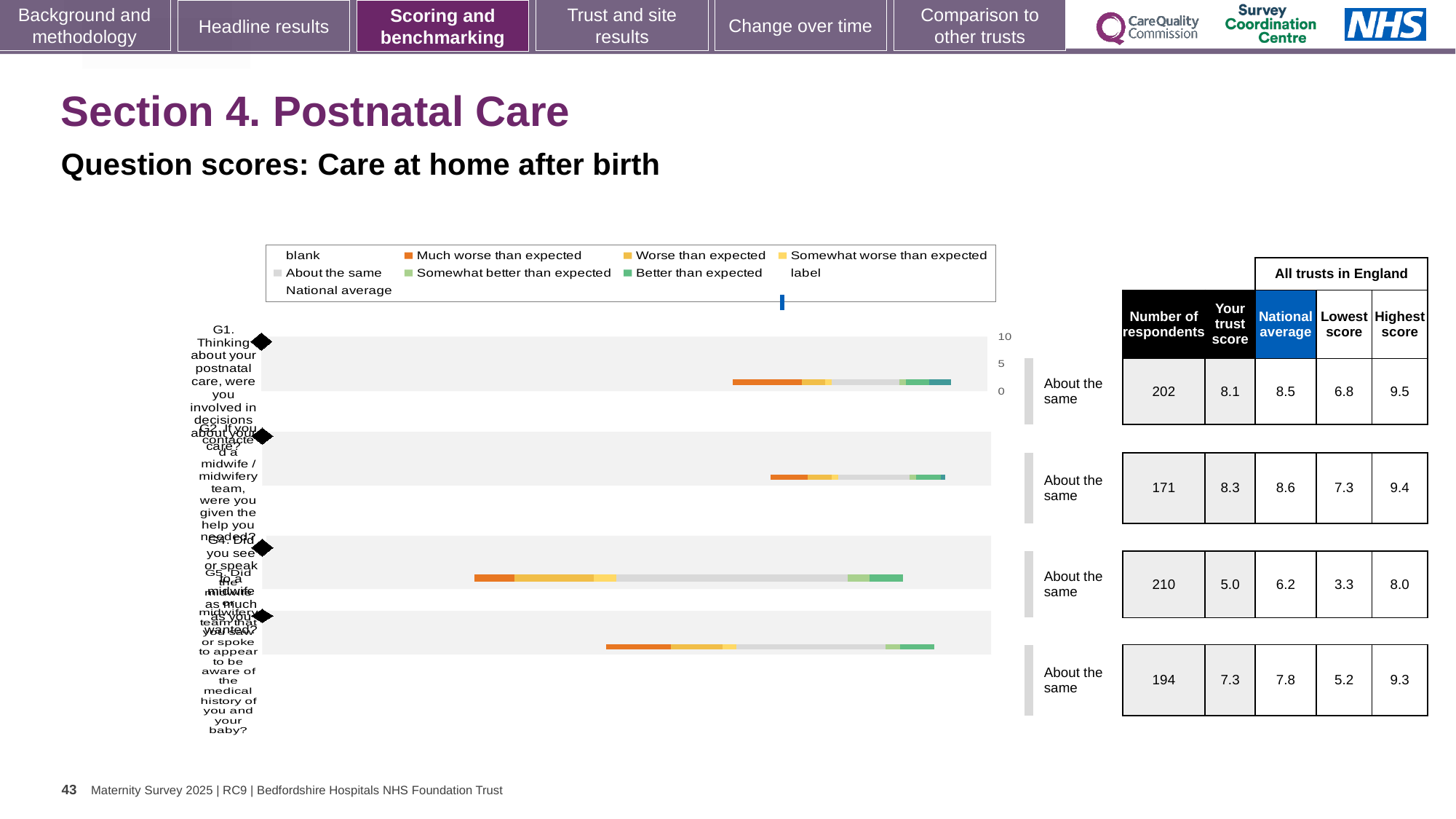
Which question row has the highest number of respondents? G4 What is the difference between the national average and the trust score for question G4? 1.2 Which question row has the lowest trust score? G4 What colour does the legend use for 'Much worse than expected'? orange What is the trust score for question G1 (involved in decisions about postnatal care)? 8.1 What is the lowest score among all trusts in England for question G1? 6.8 What is the highest score among all trusts in England for question G5? 9.3 What is the national average for question G2 (given the help you needed from the midwife / midwifery team)? 8.6 How many respondents answered question G4? 210 Is the trust score for G1 or G2 higher? G2 How many question rows (bars) are plotted in the chart? 4 What kind of chart is shown on the slide? bar chart